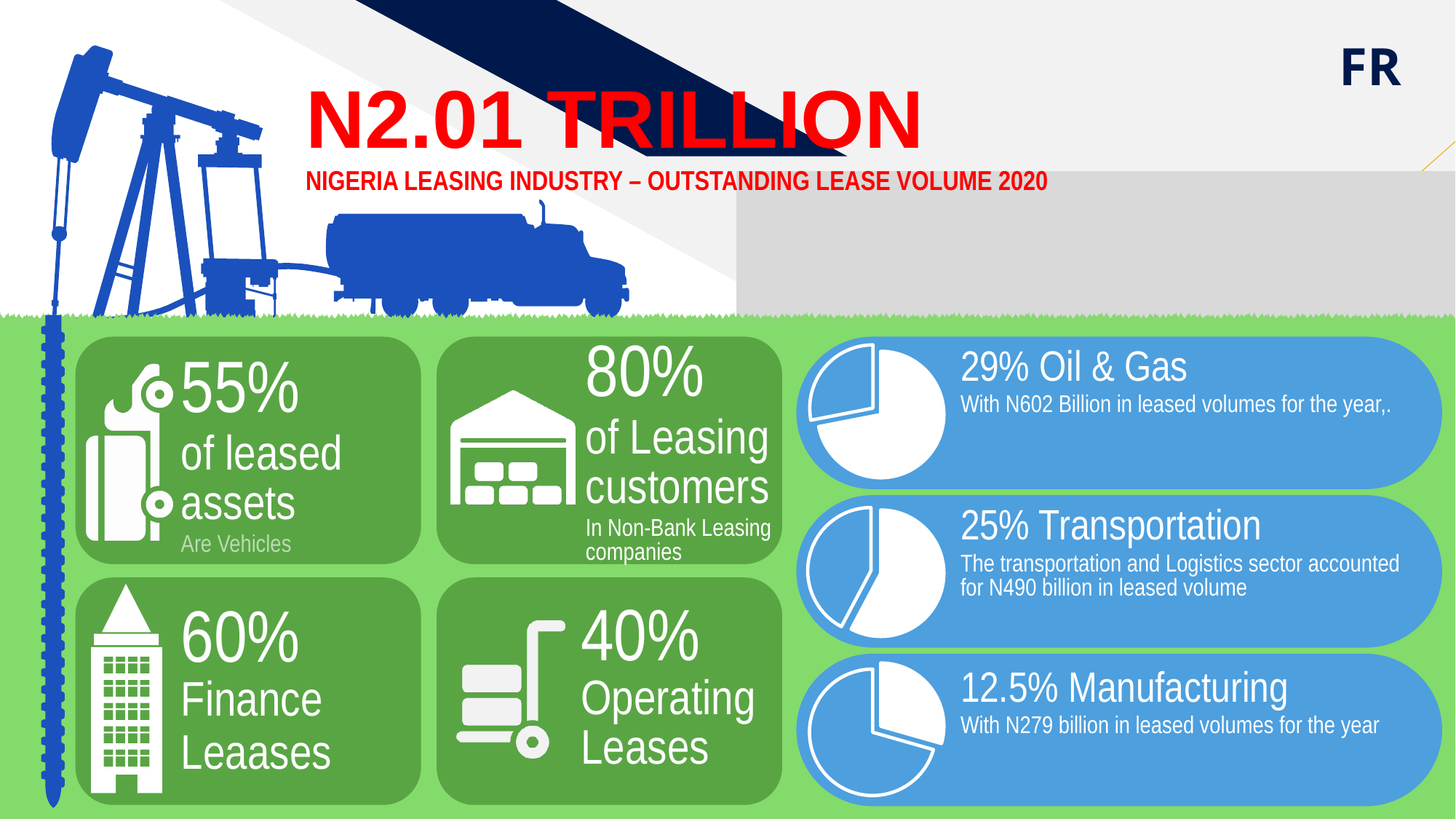
Which sector has the larger leased volume, Transportation or Manufacturing? Transportation What leased volume is given for the Transportation sector? N490 billion What is the difference in percentage points between the Oil & Gas share and the Manufacturing share? 16.5% What kind of chart is used to show each sector's share on the right side of the slide? Pie chart What share does the Manufacturing pie chart show? 12.5% What share does the Transportation pie chart show? 25% Which of the three sectors shown with pie charts has the largest share? Oil & Gas Which of the three sectors shown with pie charts has the smallest share? Manufacturing What leased volume is given for the Oil & Gas sector? N602 Billion What is the difference in percentage points between the Oil & Gas share and the Transportation share? 4% What share of outstanding lease volume does the Oil & Gas pie chart show? 29% How many sector pie charts are shown on the right side of the slide? 3